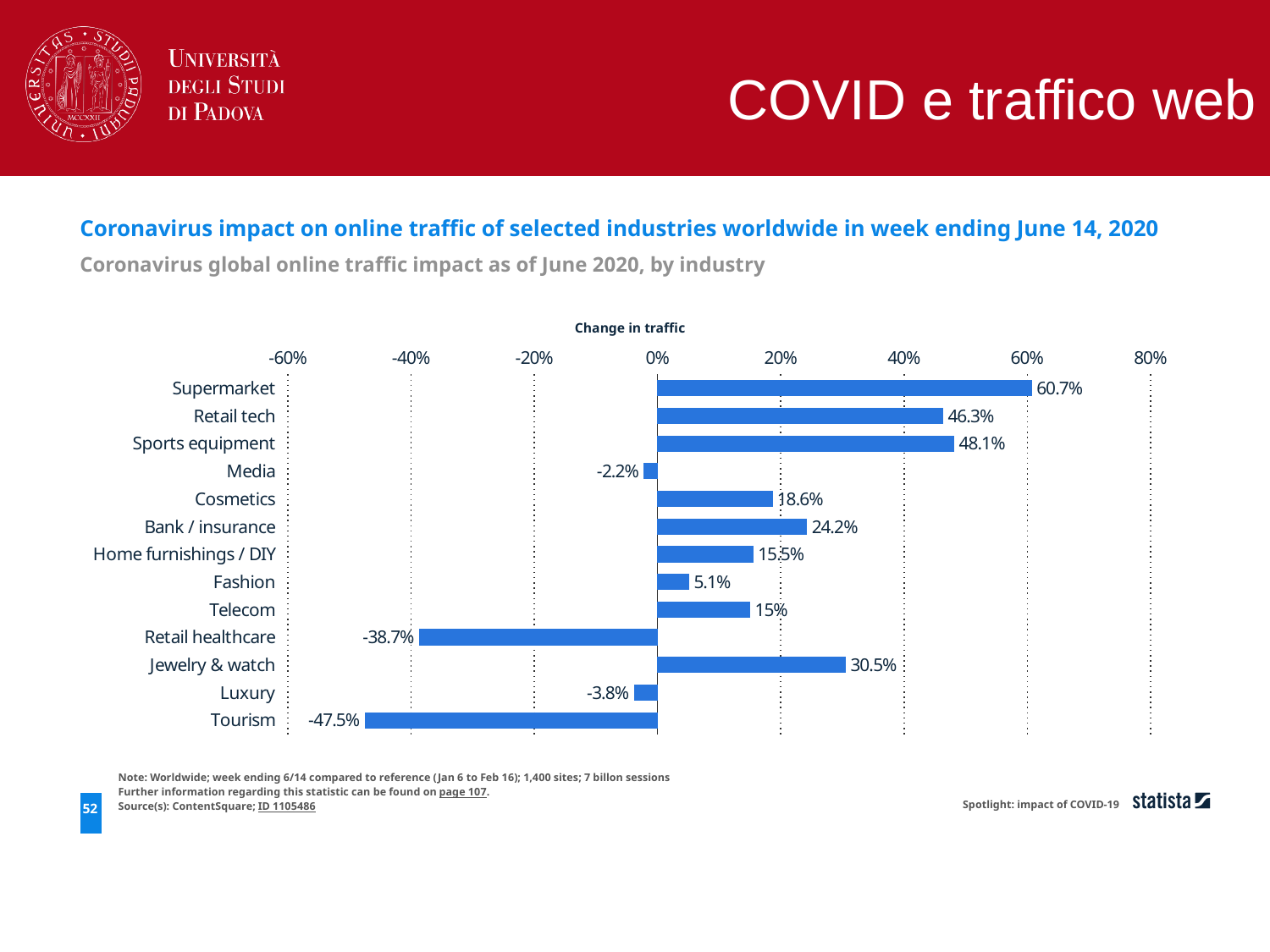
Which industry has the highest change in traffic? Supermarket What is the change in traffic for Jewelry & watch? 30.5% What is the label of the value axis of the chart? Change in traffic Which has a larger change in traffic, Bank / insurance or Cosmetics? Bank / insurance What kind of chart is shown on the slide? bar chart How many industries are shown in the chart? 13 Which industry has the lowest change in traffic? Tourism What is the difference between the change in traffic for Sports equipment and Retail tech? 1.8% What is the change in traffic for Retail healthcare? -38.7% What is the change in traffic for Supermarket? 60.7% Is the value for Tourism greater or less than -40%? less What is the change in traffic for Luxury? -3.8%